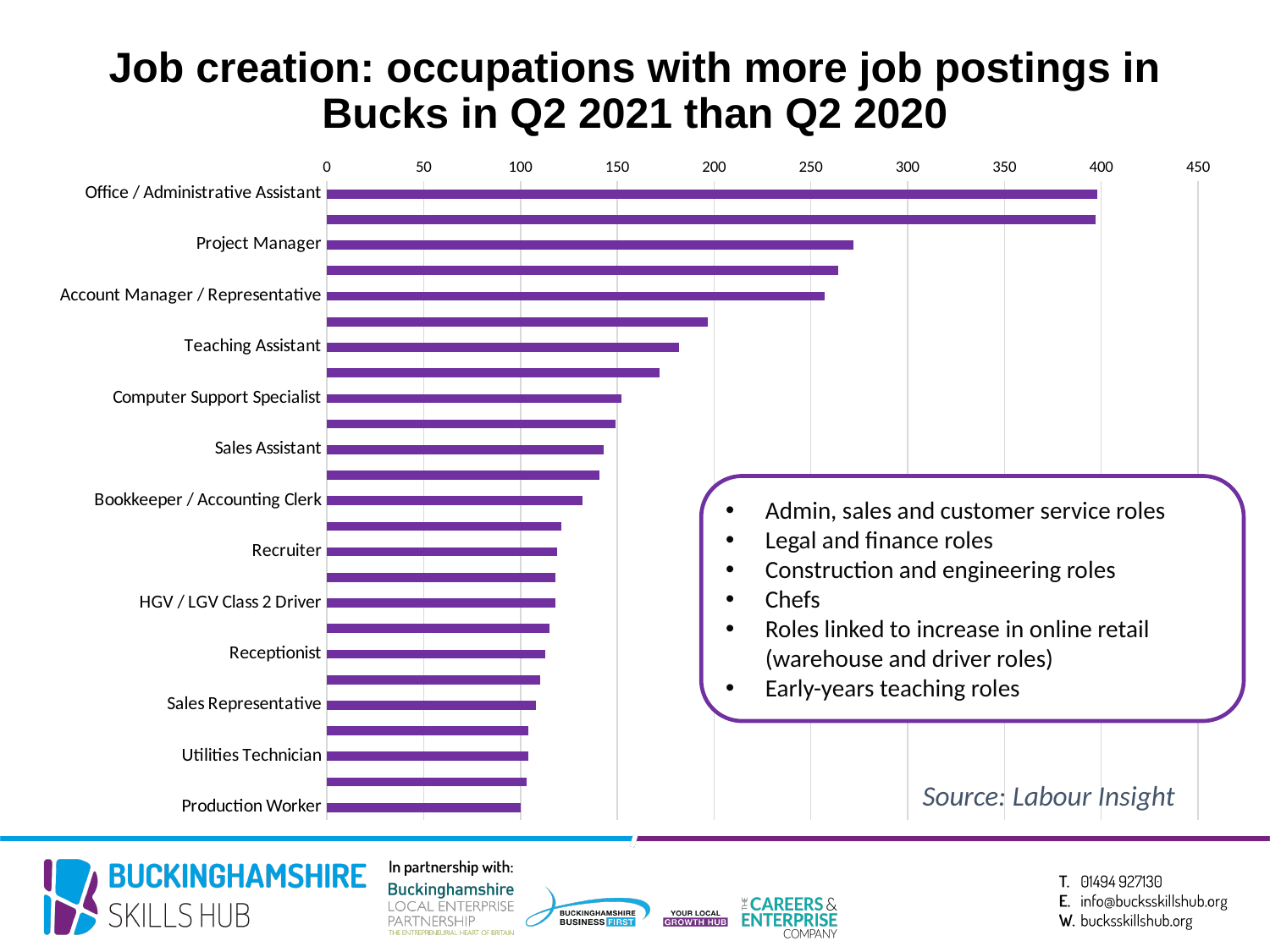
What source is cited for the chart data? Labour Insight What is the highest value shown on the horizontal axis? 450 Which occupation has the highest number of job postings in the chart? Office / Administrative Assistant Which is larger, the value for Project Manager or the value for Computer Support Specialist? Project Manager Do the bar values increase or decrease going from the top of the chart to the bottom? Decrease Is the value for Bookkeeper / Accounting Clerk greater or less than 150? less Is the value for Office / Administrative Assistant greater or less than 350? greater Is the value for Recruiter greater or less than 100? greater What kind of chart is shown on the slide? Bar chart